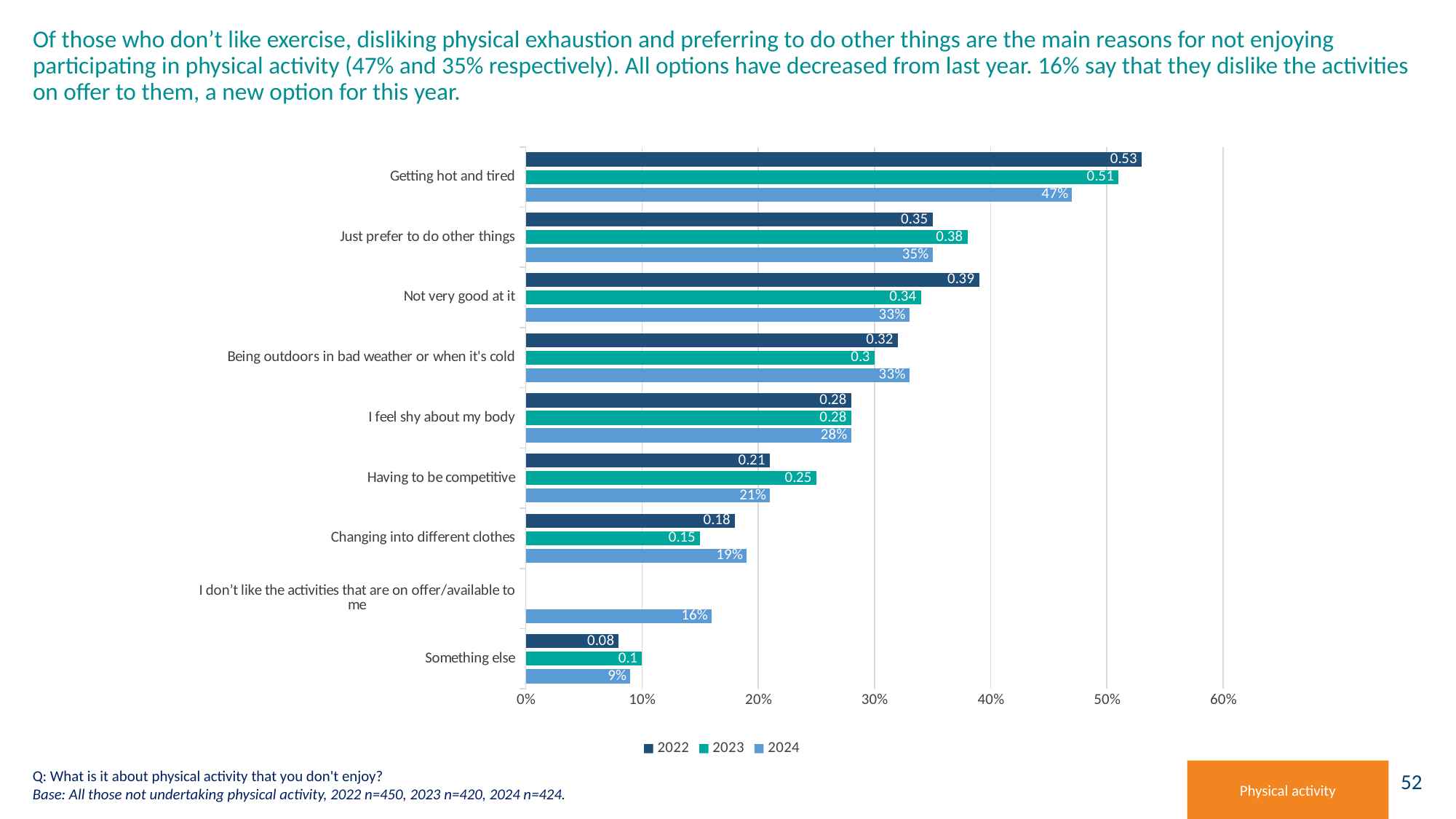
What is the 2024 value for 'I don't like the activities that are on offer/available to me'? 16% Which is larger for 'Changing into different clothes': the 2022 value or the 2023 value? 2022 Which category has the lowest 2022 value? Something else How many series does the legend list? 3 How many categories are shown on the chart? 9 Which category has no 2022 or 2023 bars, only a 2024 bar? I don't like the activities that are on offer/available to me What is the 2023 value for 'Having to be competitive'? 0.25 What type of chart is shown on the slide? Bar chart Which category has the highest 2024 value? Getting hot and tired What is the 2022 value for 'Not very good at it'? 0.39 What is the 2024 value for 'Getting hot and tired'? 47% What is the difference between the 2024 values for 'Getting hot and tired' and 'Just prefer to do other things'? 12%